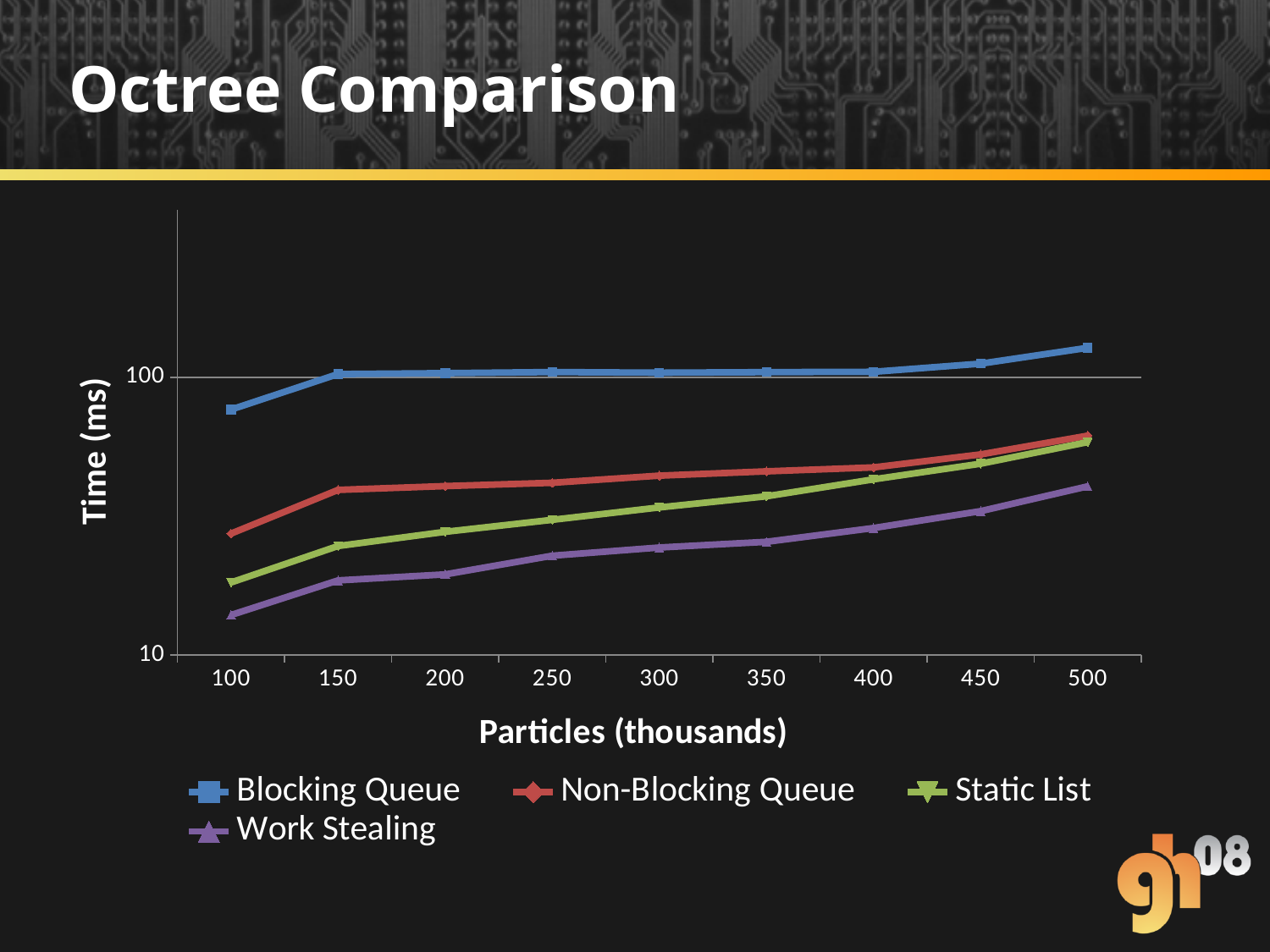
How many series does the legend list? 4 At 100 thousand particles, which is larger: Non-Blocking Queue or Static List? Non-Blocking Queue What is the label of the x axis? Particles (thousands) Is the value for Blocking Queue at 100 thousand particles greater or less than 100? less Is the value for Non-Blocking Queue at 500 thousand particles greater or less than 100? less How many data points are plotted along the x axis for each series? 9 Is the value for Blocking Queue at 500 thousand particles greater or less than 100? greater What kind of chart is shown on the slide? Line chart Which series has the highest time across all particle counts? Blocking Queue Does the Work Stealing series rise or fall as the number of particles increases? Rises What is the title of the chart? Octree Comparison Which series has the lowest time across all particle counts? Work Stealing